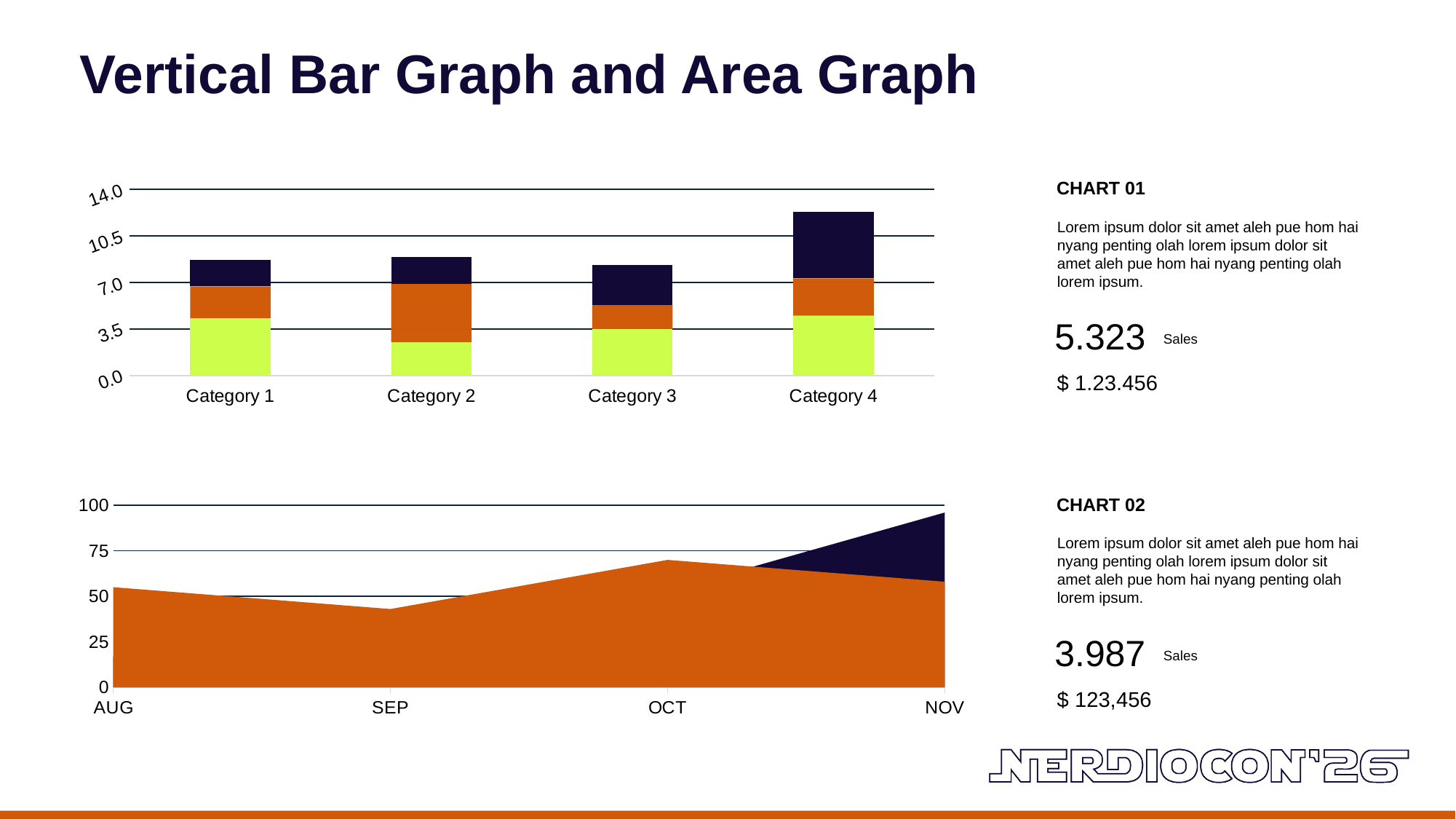
In the top bar chart, is the total for Category 1 greater or less than 10.5? less In the top bar chart, is the total for Category 4 larger than the total for Category 2? yes What kind of chart is the bottom chart on the slide? area chart In the bottom area chart, in which month is the orange series lowest? SEP In the bottom area chart, is the orange value for SEP greater or less than 50? less In the top bar chart, which category has the tallest stacked bar? Category 4 In the bottom area chart, in which month is the orange series highest? OCT In the top bar chart, how many categories are shown on the x axis? 4 In the top bar chart, is the total for Category 4 greater or less than 10.5? greater What kind of chart is the top chart on the slide? bar chart In the bottom area chart, how many months are shown on the x axis? 4